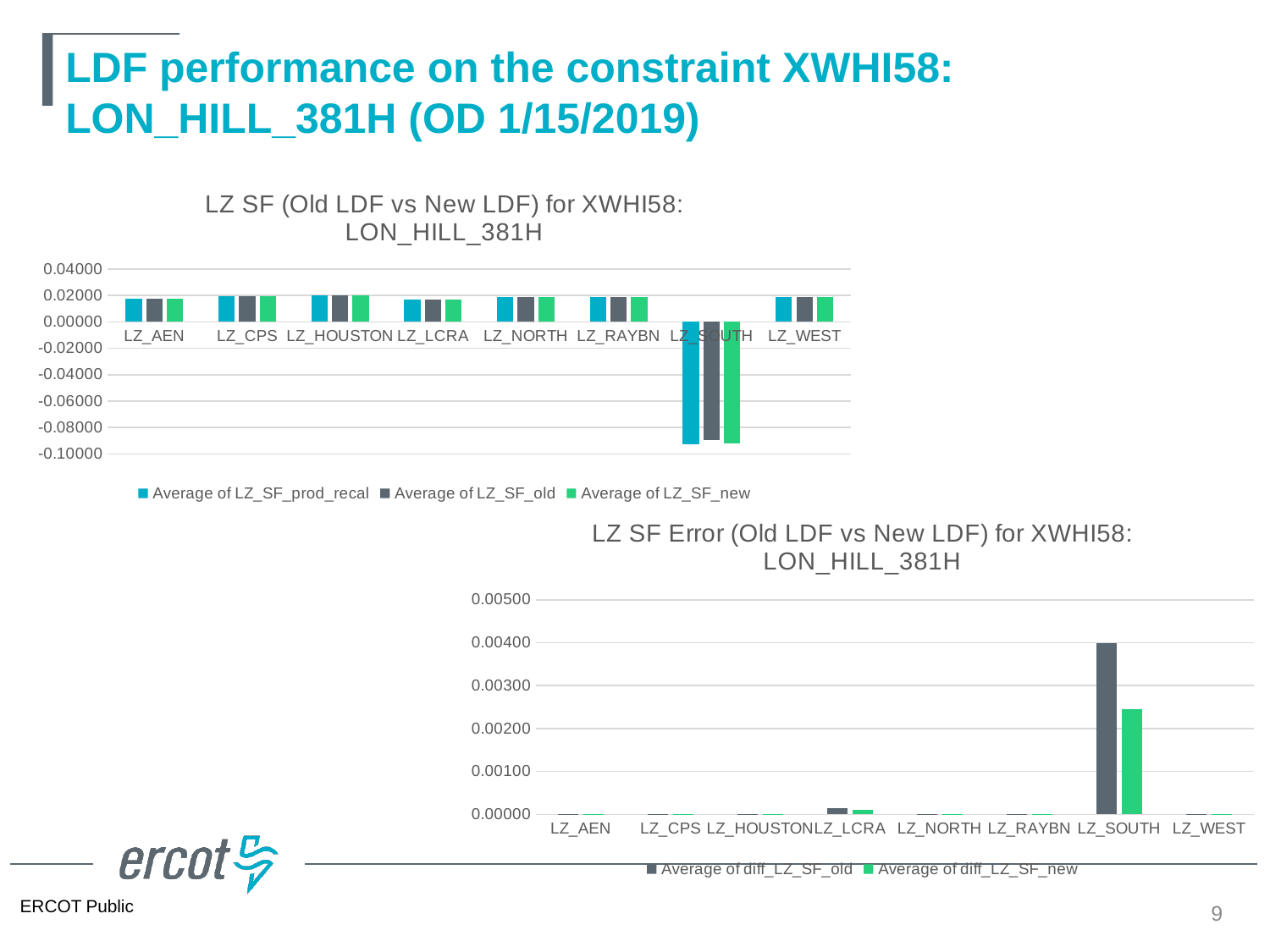
In the top chart (LZ SF (Old LDF vs New LDF) for XWHI58: LON_HILL_381H), how many series does the legend list? 3 What kind of chart is the top chart (LZ SF (Old LDF vs New LDF) for XWHI58: LON_HILL_381H)? bar chart In the top chart (LZ SF (Old LDF vs New LDF) for XWHI58: LON_HILL_381H), how many load zone categories are shown on the x axis? 8 In the top chart (LZ SF (Old LDF vs New LDF) for XWHI58: LON_HILL_381H), is the value of Average of LZ_SF_old for LZ_AEN greater or less than 0.00000? greater In the bottom chart (LZ SF Error (Old LDF vs New LDF) for XWHI58: LON_HILL_381H), which load zone has the highest error values? LZ_SOUTH In the bottom chart (LZ SF Error (Old LDF vs New LDF) for XWHI58: LON_HILL_381H), is the value of Average of diff_LZ_SF_old for LZ_SOUTH greater or less than 0.00300? greater In the bottom chart (LZ SF Error (Old LDF vs New LDF) for XWHI58: LON_HILL_381H), for LZ_SOUTH, which is larger: Average of diff_LZ_SF_old or Average of diff_LZ_SF_new? Average of diff_LZ_SF_old In the bottom chart (LZ SF Error (Old LDF vs New LDF) for XWHI58: LON_HILL_381H), how many series does the legend list? 2 In the bottom chart (LZ SF Error (Old LDF vs New LDF) for XWHI58: LON_HILL_381H), what is the name of the series shown in green? Average of diff_LZ_SF_new In the bottom chart (LZ SF Error (Old LDF vs New LDF) for XWHI58: LON_HILL_381H), is the value of Average of diff_LZ_SF_new for LZ_SOUTH greater or less than 0.00300? less In the top chart (LZ SF (Old LDF vs New LDF) for XWHI58: LON_HILL_381H), which load zone has the lowest values? LZ_SOUTH